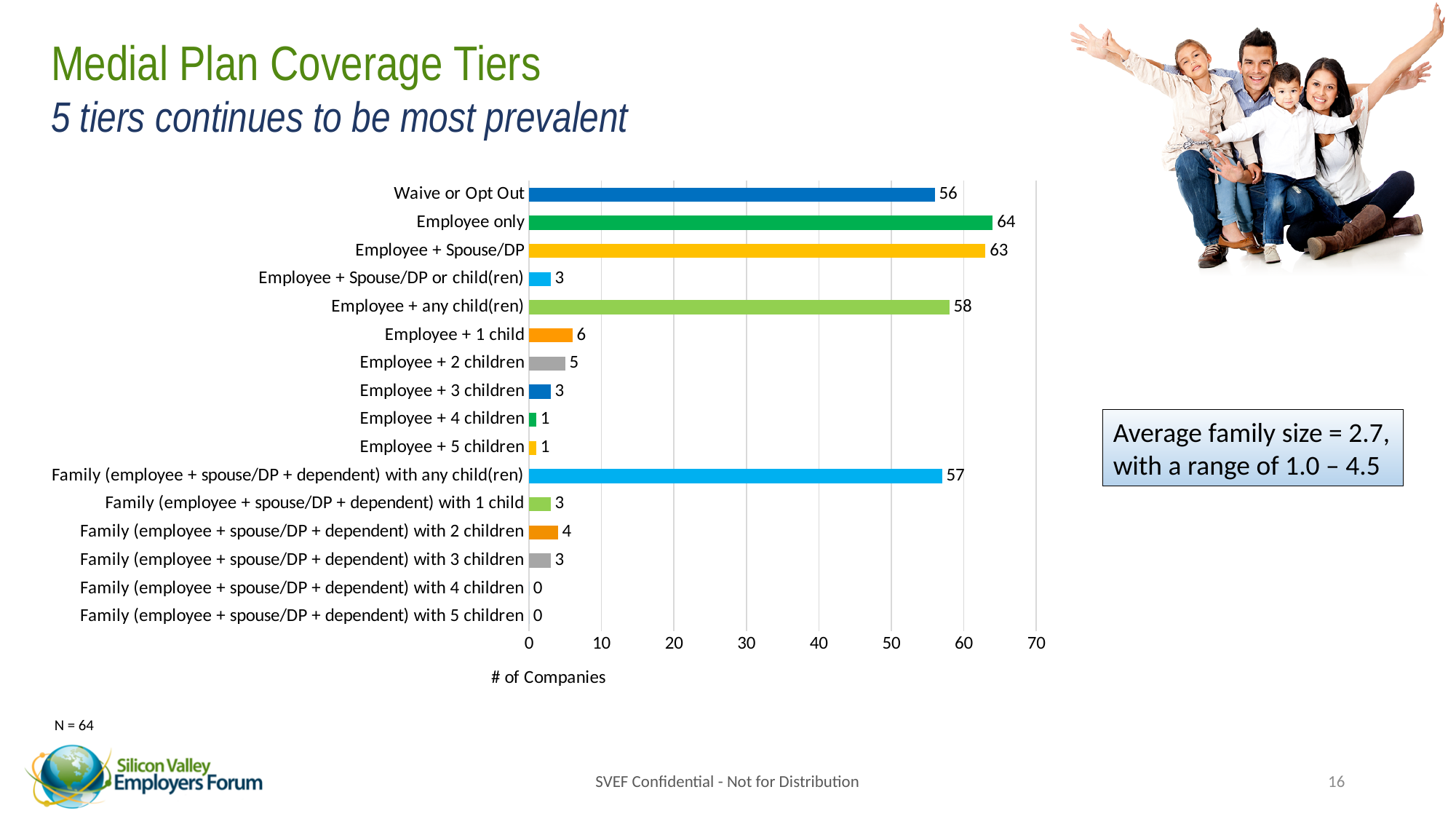
What is the value for Family (employee + spouse/DP + dependent) with 4 children? 0 What kind of chart is shown on the slide? bar chart What is the difference between the values for Employee + Spouse/DP and Employee + any child(ren)? 5 How many coverage tier categories are shown on the chart? 16 Which coverage tier has the highest number of companies? Employee only What is the label of the horizontal axis? # of Companies What is the difference between the values for Employee only and Waive or Opt Out? 8 How many companies offer the Family (employee + spouse/DP + dependent) with any child(ren) tier? 57 Is the value for Employee + Spouse/DP greater or less than 60? greater Which is larger, the value for Employee + 1 child or the value for Employee + 2 children? Employee + 1 child How many companies offer the Employee only coverage tier? 64 What is the value for Waive or Opt Out? 56